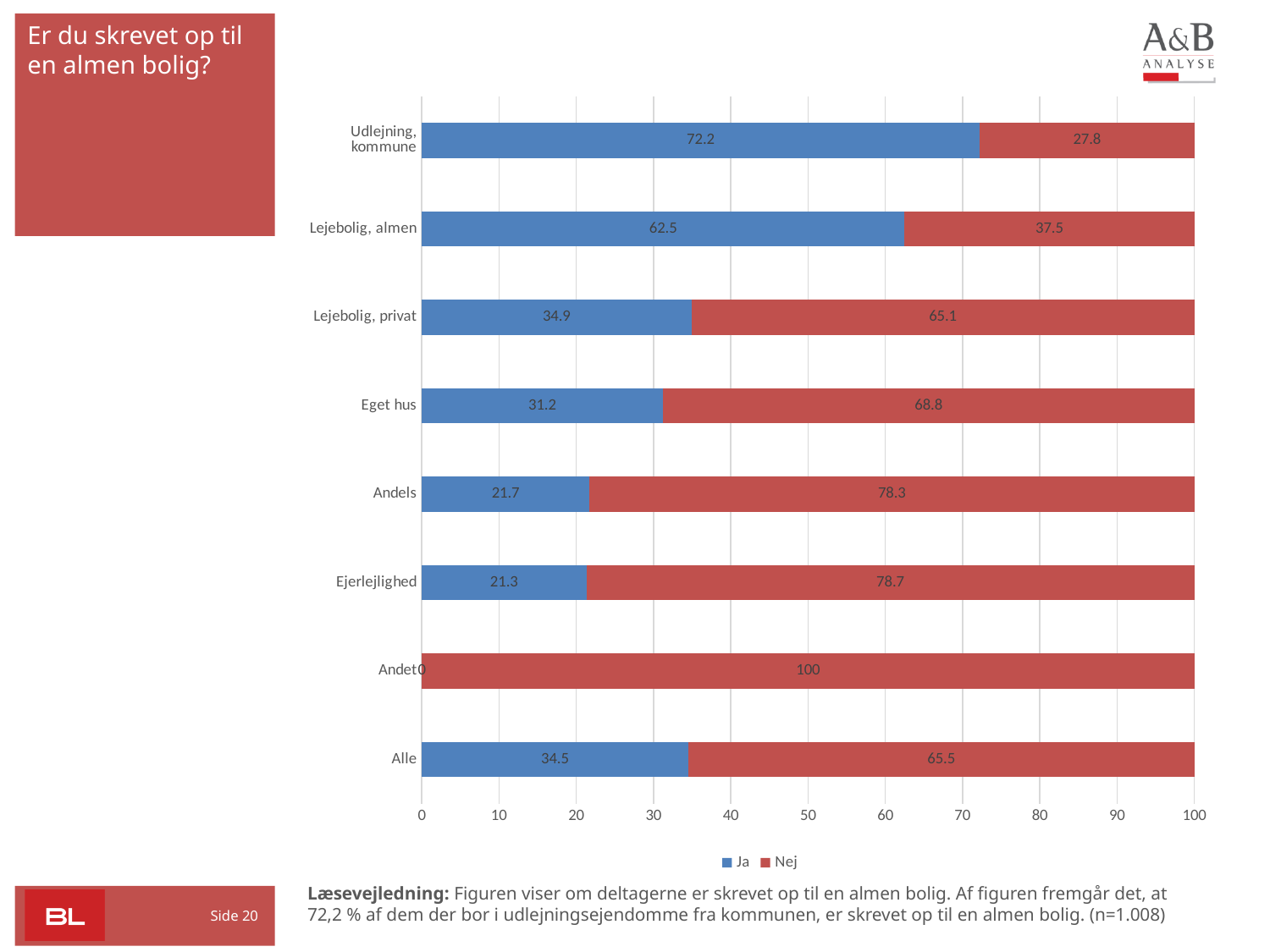
Which is larger, the "Ja" value for "Andels" or for "Ejerlejlighed"? Andels What is the total of the stacked bar for "Ejerlejlighed"? 100 What kind of chart is shown? Stacked bar chart What is the difference between the "Nej" values for "Eget hus" and "Lejebolig, privat"? 3.7 How many series does the legend list? 2 What is the "Ja" value for "Alle"? 34.5 Is the "Ja" value for "Lejebolig, almen" greater or less than 60? greater Which category has the highest "Ja" value? Udlejning, kommune What is the "Nej" value for "Lejebolig, almen"? 37.5 What is the "Ja" value for "Udlejning, kommune"? 72.2 Which category has the lowest "Ja" value? Andet How many categories are shown on the y axis? 8